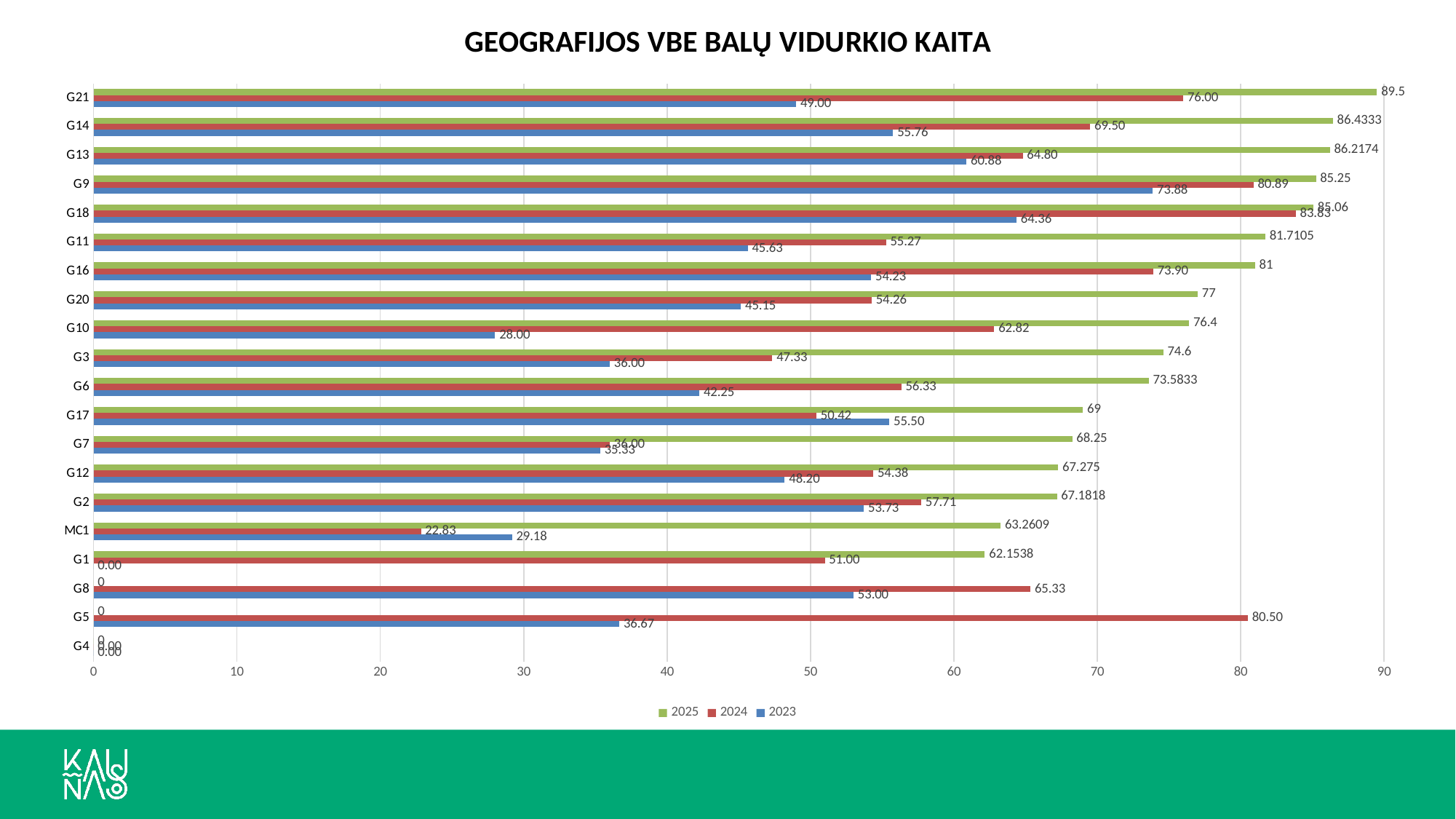
How many series does the legend list? 3 What is the 2025 value for MC1? 63.2609 For G17, which is larger: the 2023 value or the 2024 value? 2023 What is the difference between the 2025 and 2024 values for G21? 13.5 Which category has the highest 2025 value? G21 How many categories are shown on the chart? 20 What is the title of the chart? GEOGRAFIJOS VBE BALŲ VIDURKIO KAITA What kind of chart is shown on the slide? Bar chart Which category has the highest 2024 value? G18 What is the 2024 value for G5? 80.50 What is the 2025 value for G21? 89.5 What is the 2023 value for G10? 28.00